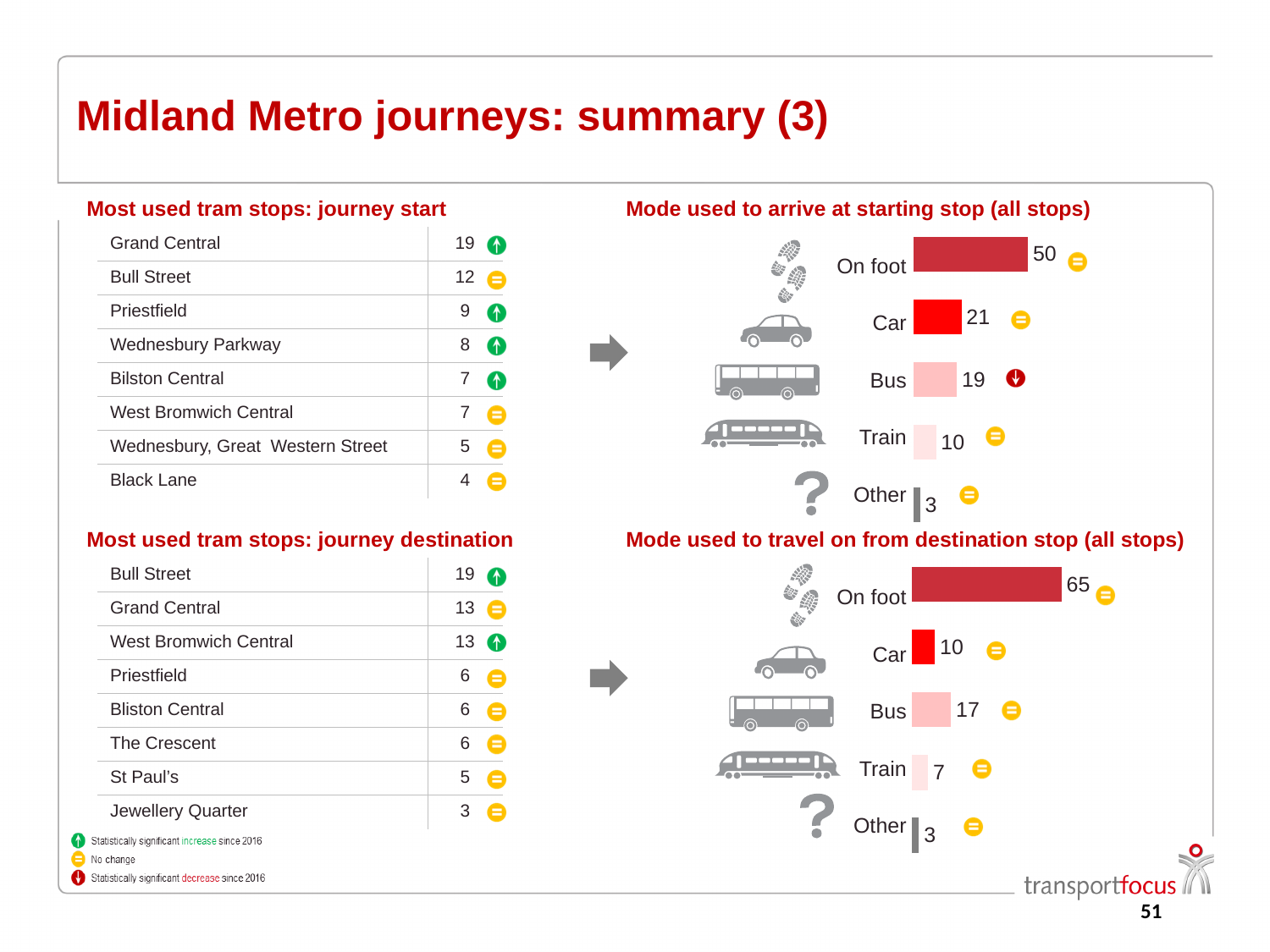
In the 'Mode used to travel on from destination stop (all stops)' chart, which is larger, the value for Car or the value for Bus? Bus In the 'Mode used to arrive at starting stop (all stops)' chart, what is the value for On foot? 50 In the 'Mode used to arrive at starting stop (all stops)' chart, what is the value for Bus? 19 In the 'Mode used to travel on from destination stop (all stops)' chart, which mode has the highest value? On foot In the 'Mode used to arrive at starting stop (all stops)' chart, which mode has the lowest value? Other In the 'Mode used to travel on from destination stop (all stops)' chart, what is the difference between the values for On foot and Bus? 48 In the 'Mode used to travel on from destination stop (all stops)' chart, what is the value for Train? 7 In the 'Mode used to travel on from destination stop (all stops)' chart, what is the value for On foot? 65 What kind of chart is 'Mode used to arrive at starting stop (all stops)'? Bar chart In the 'Mode used to arrive at starting stop (all stops)' chart, what is the difference between the values for Car and Train? 11 In the 'Mode used to arrive at starting stop (all stops)' chart, how many modes are shown? 5 In the 'Mode used to arrive at starting stop (all stops)' chart, which mode is marked with a statistically significant decrease since 2016? Bus